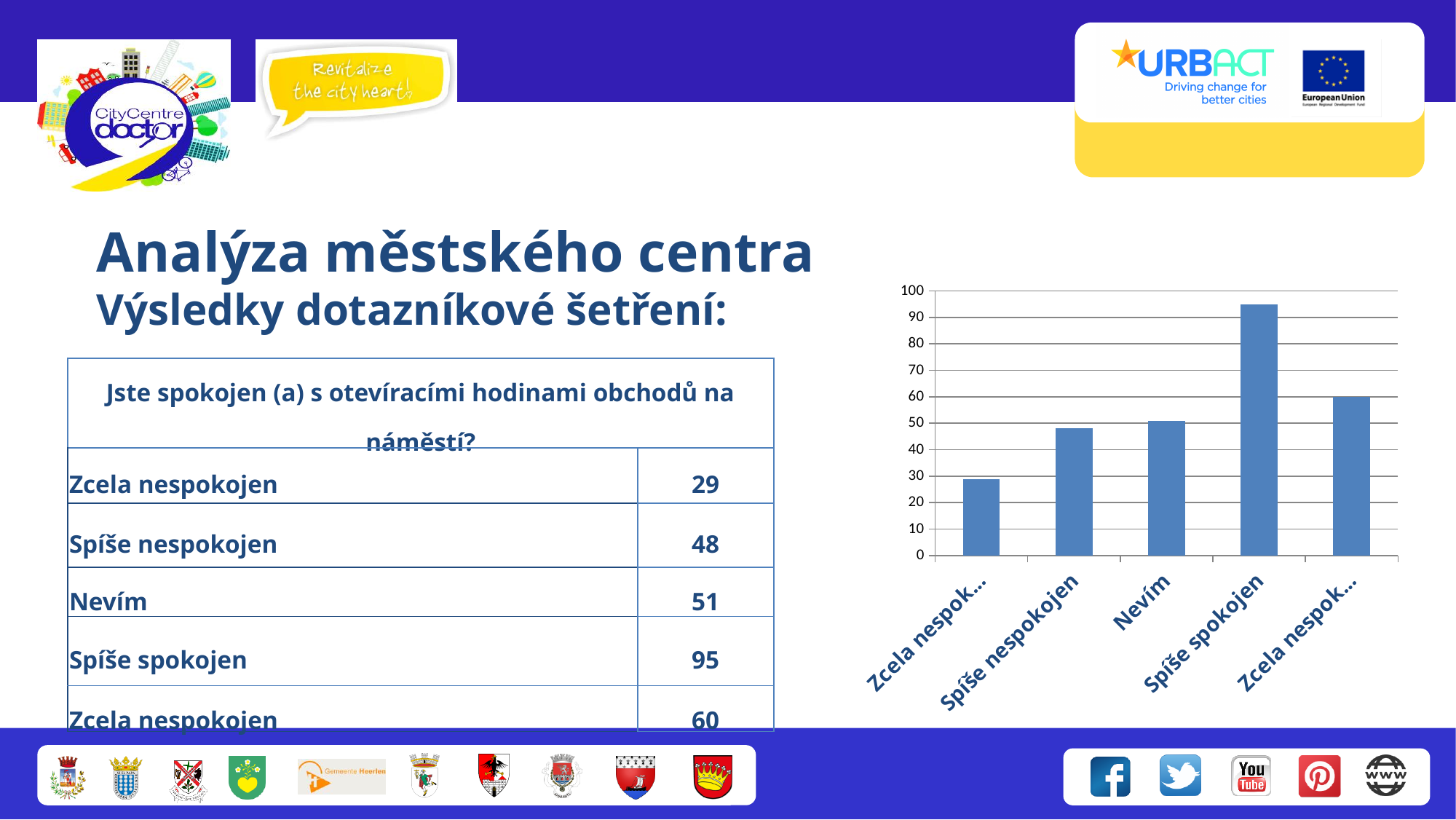
Which category has the highest bar in the chart? Spíše spokojen Which bar is the lowest in the chart? the leftmost bar (Zcela nespokojen, 29) What is the value for Nevím? 51 Is the value of the rightmost bar greater or less than 50? greater What kind of chart is shown on the slide? bar chart What is the value for Spíše spokojen? 95 Which is larger, the value for Spíše spokojen or the value for Nevím? Spíše spokojen What is the value for Spíše nespokojen? 48 Is the value for Spíše spokojen greater or less than 90? greater How many bars does the chart have? 5 What is the difference between the values for Spíše spokojen and Nevím? 44 What survey question do the chart's values answer, according to the table on the slide? Jste spokojen (a) s otevíracími hodinami obchodů na náměstí?